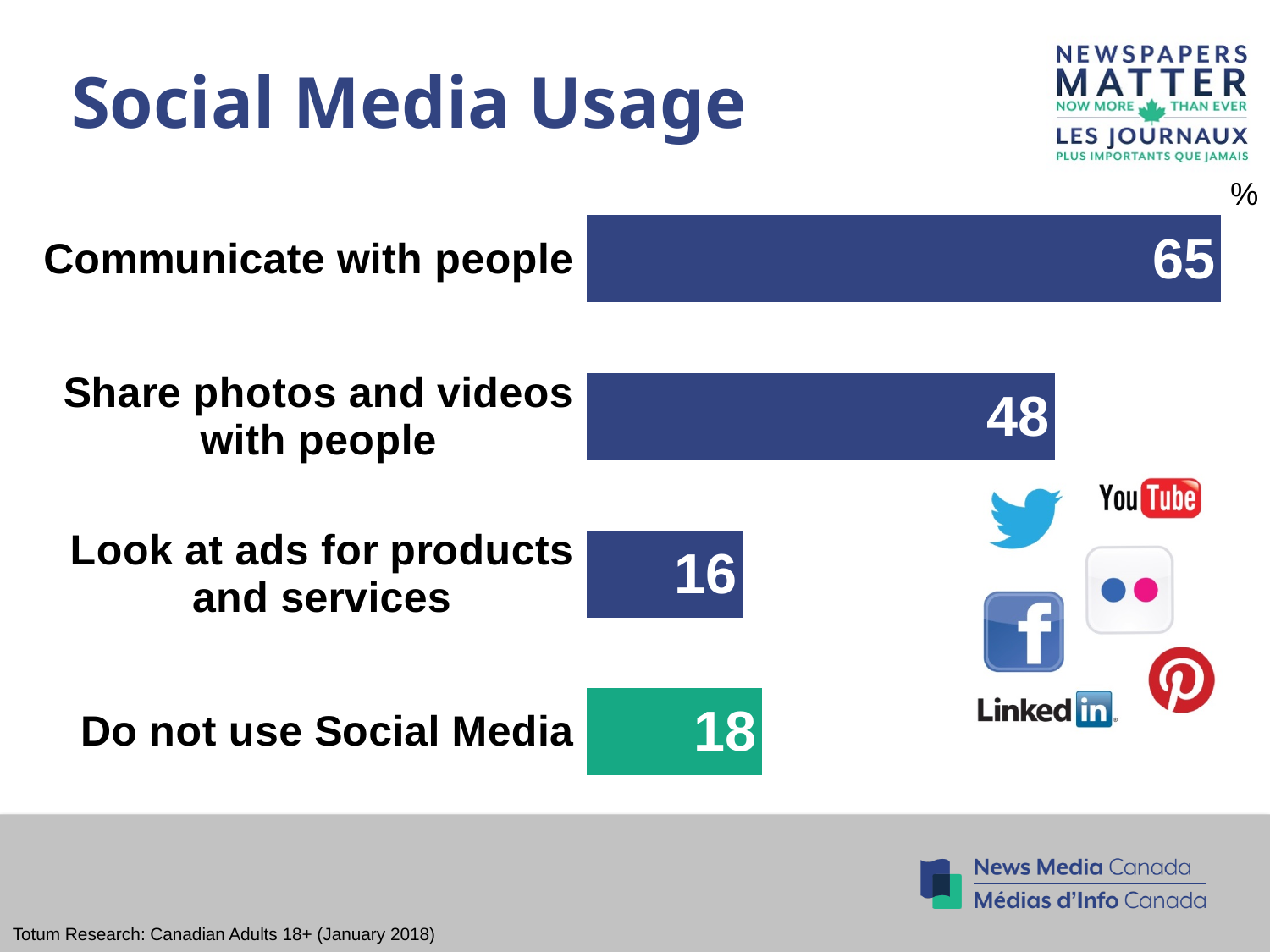
Which is larger, the value for "Do not use Social Media" or the value for "Look at ads for products and services"? Do not use Social Media What is the difference between the values for "Communicate with people" and "Share photos and videos with people"? 17 What is the value for "Share photos and videos with people"? 48 Which bar is shown in a different colour (green) from the others? Do not use Social Media What is the difference between the values for "Do not use Social Media" and "Look at ads for products and services"? 2 What is the value for "Communicate with people"? 65 Which category has the lowest value? Look at ads for products and services What is the value for "Do not use Social Media"? 18 How many categories are shown in the chart? 4 What is the value for "Look at ads for products and services"? 16 What kind of chart is shown on the slide? Bar chart Which category has the highest value? Communicate with people